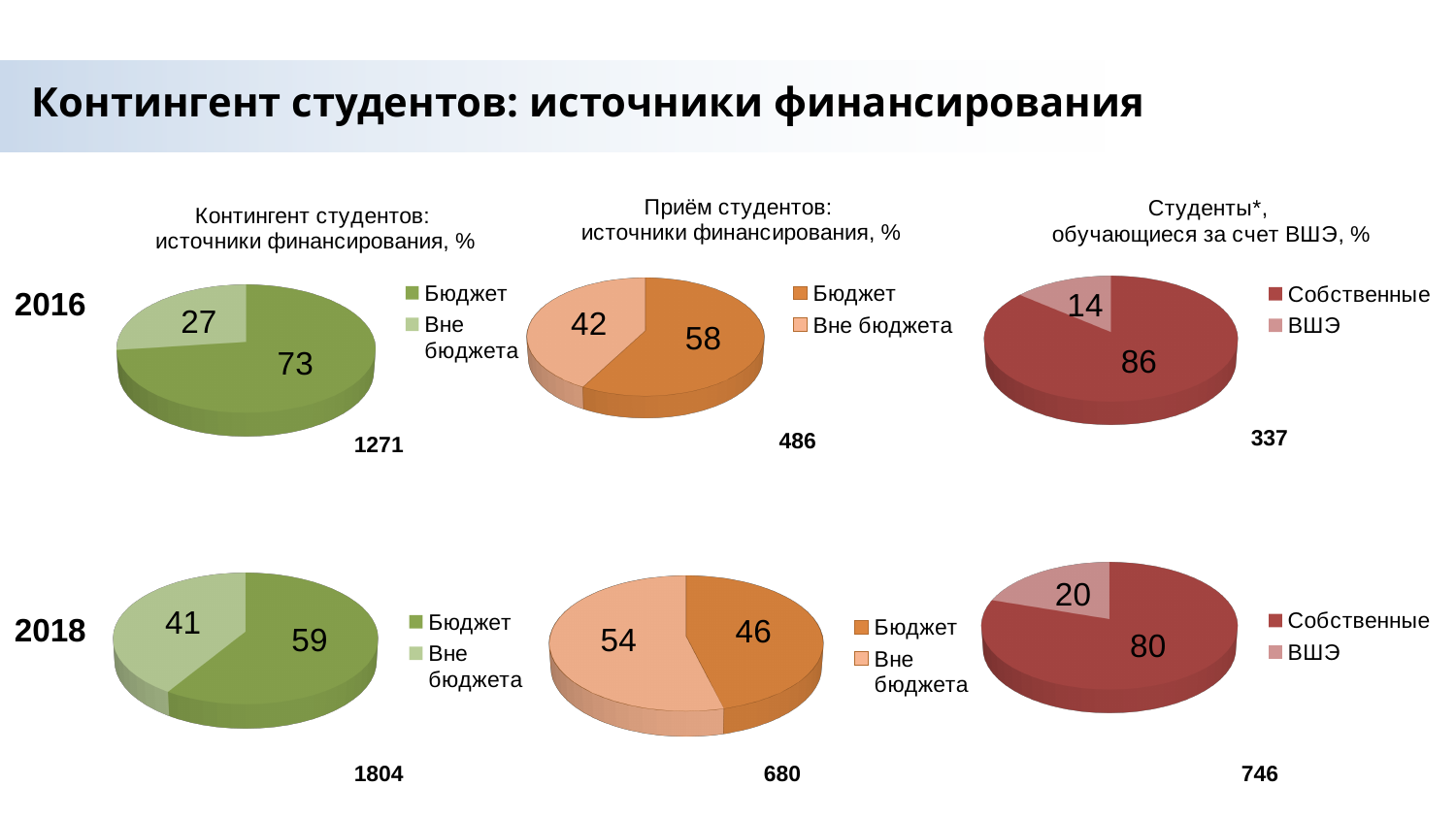
How many entries does the legend of the 2016 pie chart titled 'Контингент студентов: источники финансирования, %' list? 2 In the 2016 pie chart titled 'Студенты*, обучающиеся за счет ВШЭ, %', what is the value for 'ВШЭ'? 14 In the 2016 pie chart titled 'Контингент студентов: источники финансирования, %', what is the difference between the 'Бюджет' and 'Вне бюджета' values? 46 What number is printed below the 2018 pie chart titled 'Контингент студентов: источники финансирования, %'? 1804 In the 2018 pie chart titled 'Приём студентов: источники финансирования, %', which slice is larger, 'Бюджет' or 'Вне бюджета'? Вне бюджета In the 2018 pie chart titled 'Студенты*, обучающиеся за счет ВШЭ, %', what is the value for 'Собственные'? 80 In the 2016 pie chart titled 'Контингент студентов: источники финансирования, %', what is the value for 'Бюджет'? 73 In the 2018 pie chart titled 'Контингент студентов: источники финансирования, %', what is the value for 'Вне бюджета'? 41 In the 2016 pie chart titled 'Приём студентов: источники финансирования, %', what is the value for 'Вне бюджета'? 42 How many slices does the 2018 pie chart titled 'Студенты*, обучающиеся за счет ВШЭ, %' have? 2 What type of chart is used for the 2016 'Приём студентов: источники финансирования, %' data? Pie chart In the 2018 pie chart titled 'Приём студентов: источники финансирования, %', what is the difference between the 'Вне бюджета' and 'Бюджет' values? 8